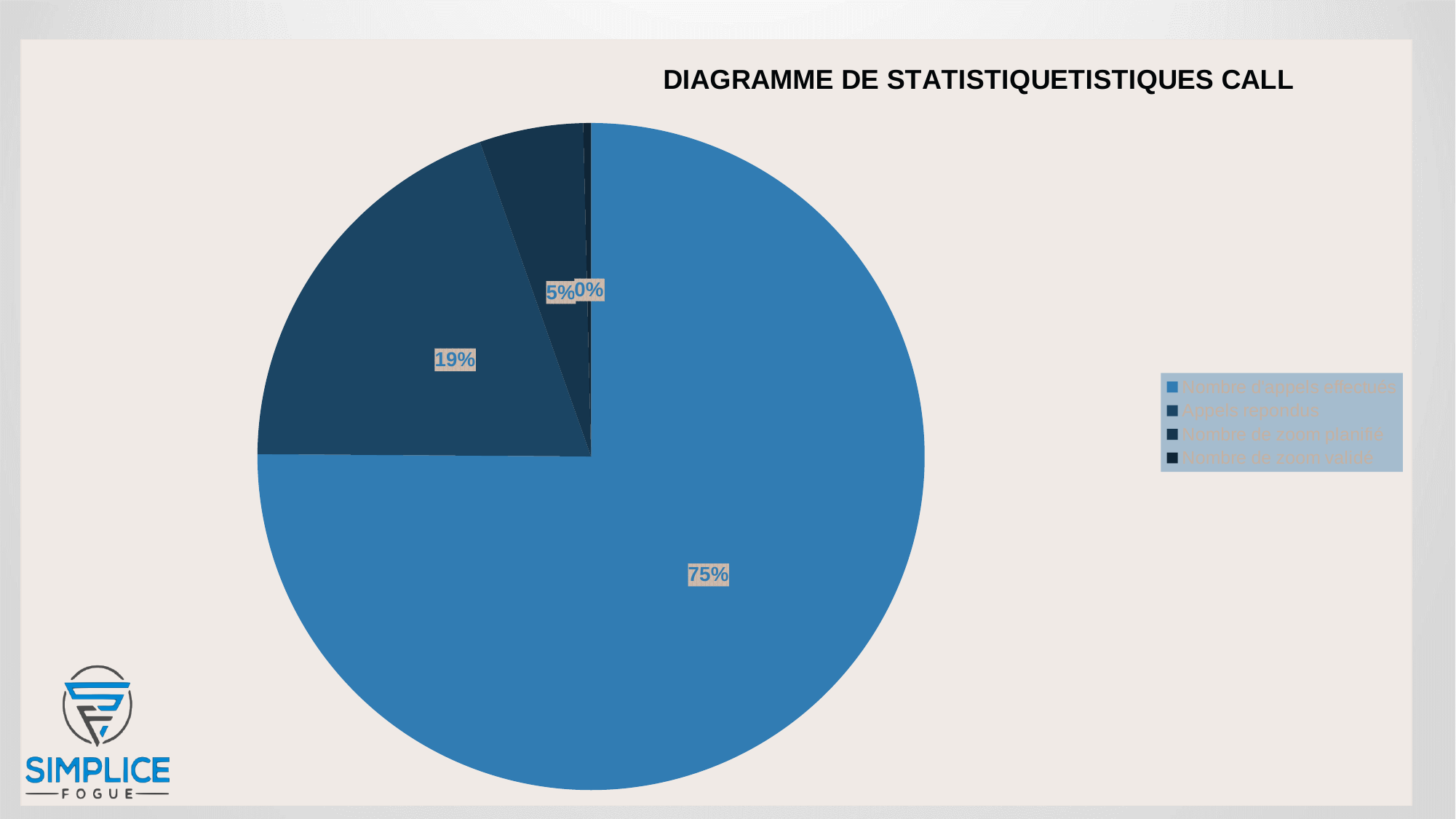
What share of the pie does 'Appels répondus' represent? 19% Which category has the smallest slice of the pie? Nombre de zoom validé How many entries does the legend list? 4 What is the title of the chart? DIAGRAMME DE STATISTIQUETISTIQUES CALL What kind of chart is shown on the slide? pie chart How many slices does the pie chart have? 4 What is the difference in percentage points between 'Nombre d'appels effectués' and 'Appels répondus'? 56 What share of the pie does 'Nombre de zoom validé' represent? 0% What share of the pie does 'Nombre d'appels effectués' represent? 75% Which is larger, the slice for 'Appels répondus' or the slice for 'Nombre de zoom planifié'? Appels répondus Which category has the largest slice of the pie? Nombre d'appels effectués